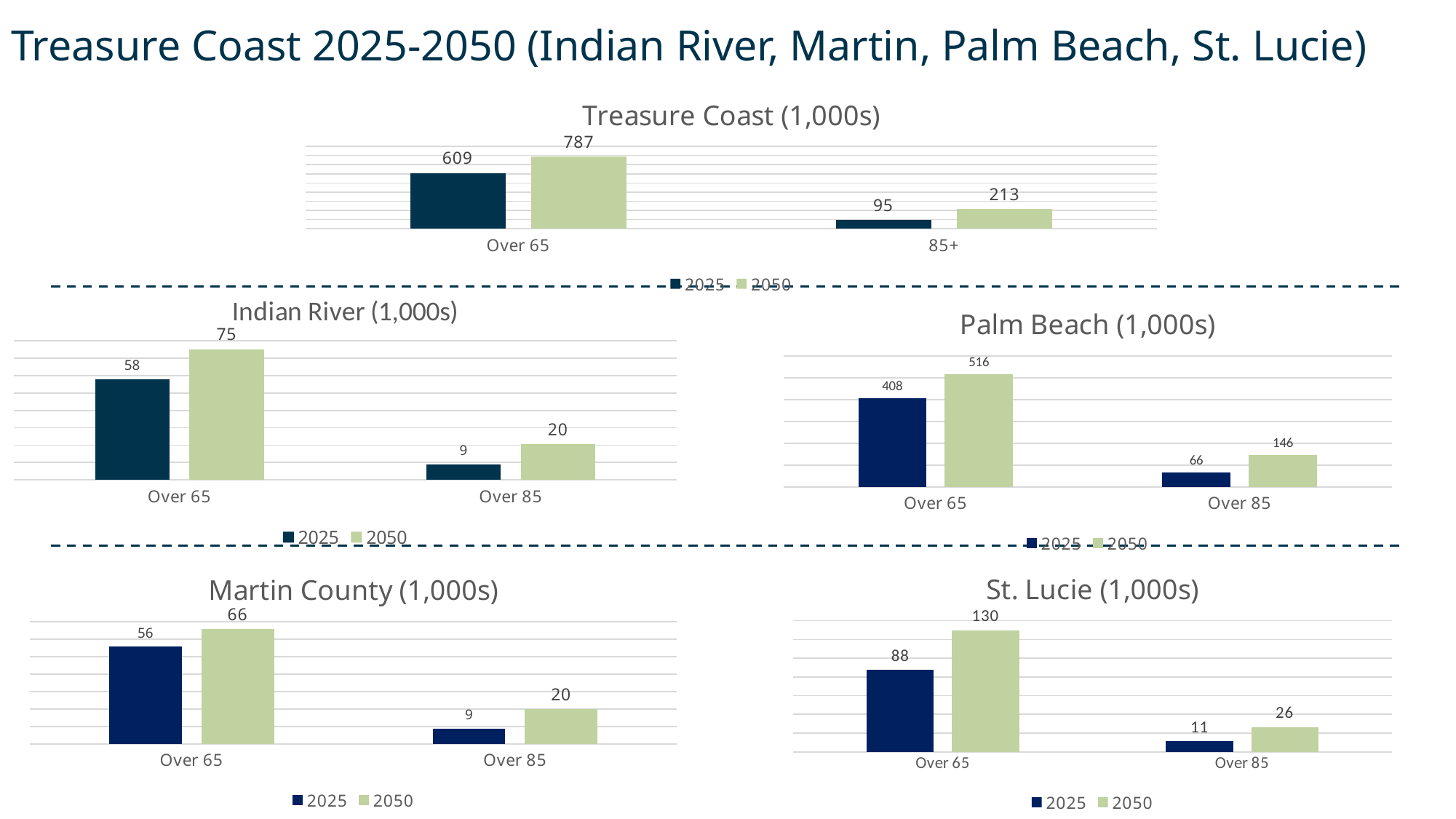
In the Indian River (1,000s) chart, what is the difference between the 2050 and 2025 values for Over 65? 17 In the St. Lucie (1,000s) chart, what is the difference between the 2050 and 2025 values for Over 85? 15 In the Martin County (1,000s) chart, what is the 2025 value for Over 65? 56 In the Treasure Coast (1,000s) chart, what is the difference between the 2050 and 2025 values for Over 65? 178 What kind of chart is the Palm Beach (1,000s) chart? Bar chart In the Treasure Coast (1,000s) chart, what is the 2025 value for 85+? 95 In the Palm Beach (1,000s) chart, which is larger, the 2025 value for Over 85 or the 2050 value for Over 85? 2050 In the Palm Beach (1,000s) chart, what is the 2025 value for Over 65? 408 In the St. Lucie (1,000s) chart, what is the 2050 value for Over 65? 130 In the Treasure Coast (1,000s) chart, what is the 2050 value for Over 65? 787 How many series does the legend of the Martin County (1,000s) chart list? 2 In the Indian River (1,000s) chart, what is the 2050 value for Over 85? 20